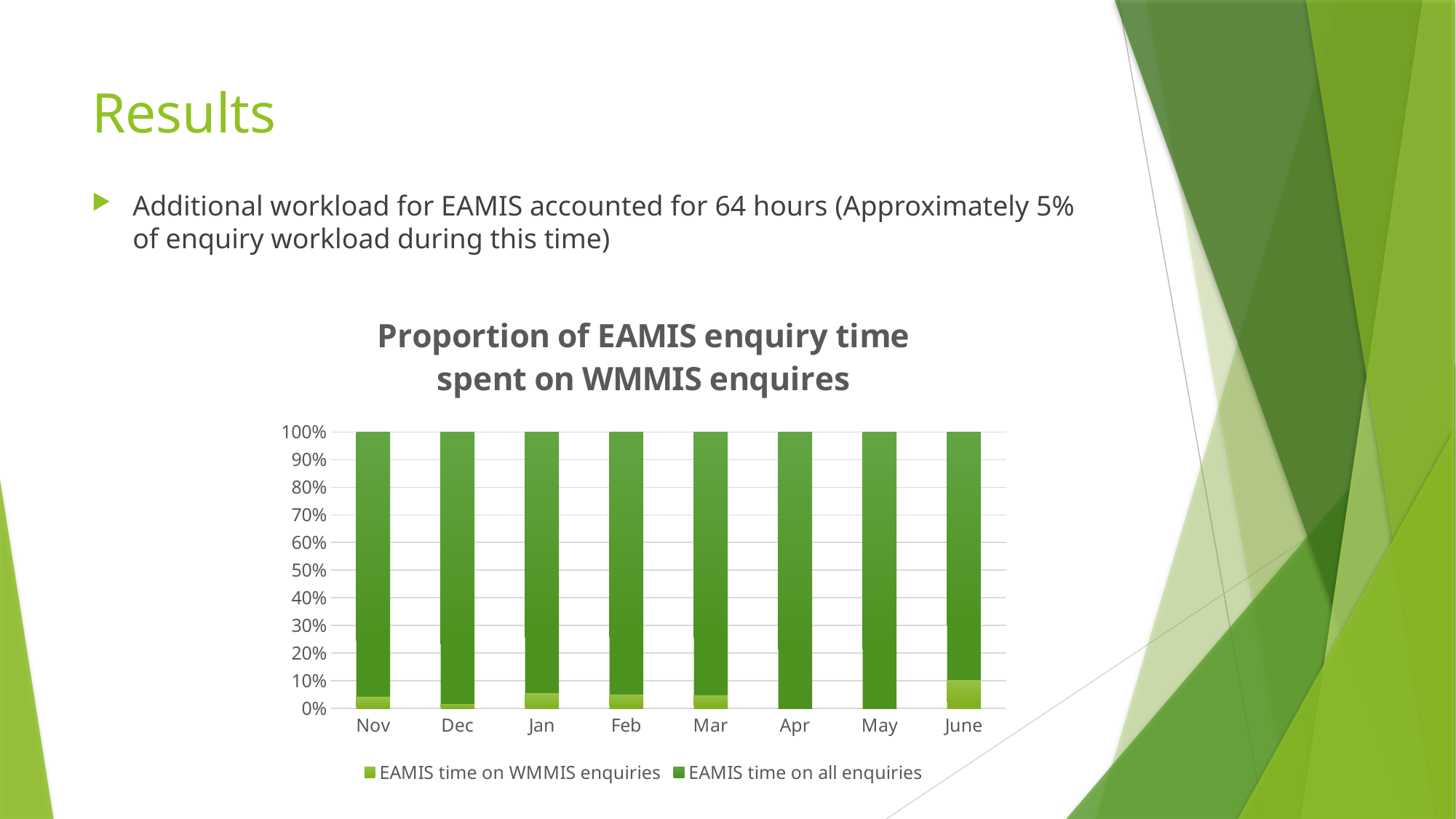
In which month is the proportion of EAMIS time on WMMIS enquiries the highest? June Is the proportion of EAMIS time on WMMIS enquiries in Dec greater or less than 5%? less What is the title of the chart? Proportion of EAMIS enquiry time spent on WMMIS enquires Which series is shown in the lighter green colour in the chart? EAMIS time on WMMIS enquiries Which month has a larger proportion of EAMIS time on WMMIS enquiries, June or Nov? June How many months are shown on the x axis of the chart? 8 How many series does the chart legend list? 2 Is the proportion of EAMIS time on WMMIS enquiries in June greater or less than 5%? greater Which month has a larger proportion of EAMIS time on WMMIS enquiries, Dec or Jan? Jan What type of chart is shown on the slide? Stacked bar chart What is the total height of each stacked bar in the chart? 100% Is the proportion of EAMIS time on WMMIS enquiries in Nov greater or less than 10%? less